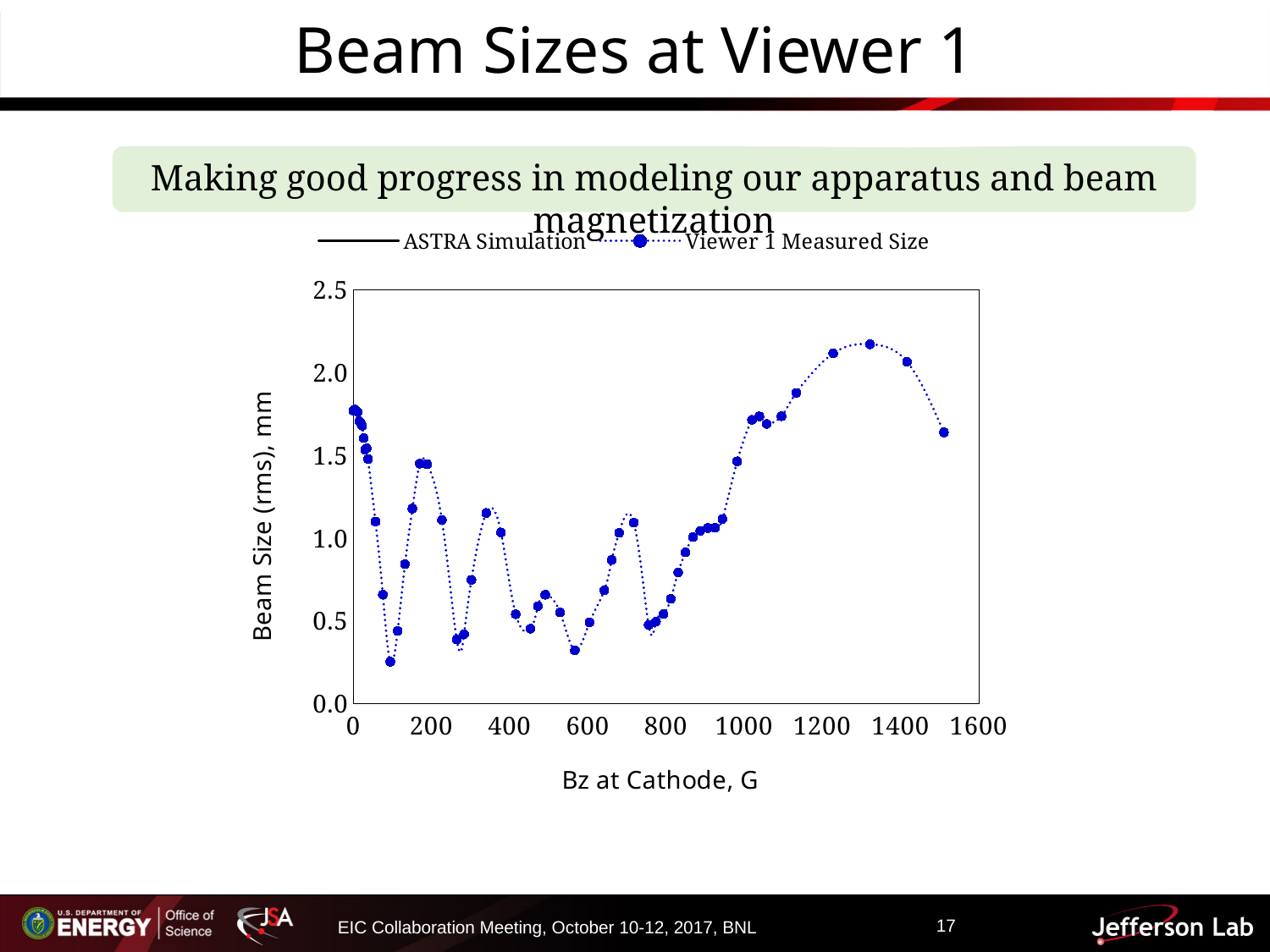
What is the maximum value shown on the y axis? 2.5 Is the Viewer 1 Measured Size at Bz = 0 G greater or less than 1.5 mm? greater Does the Viewer 1 Measured Size rise or fall as Bz increases from 1000 G to 1300 G? rise What kind of chart is shown on the slide? line chart Does the Viewer 1 Measured Size rise or fall as Bz increases from 1300 G to 1500 G? fall What is the label of the y axis? Beam Size (rms), mm Which is larger, the Viewer 1 Measured Size at about 1300 G or at about 100 G? at about 1300 G Is the highest Viewer 1 Measured Size on the chart greater or less than 2.0 mm? greater Is the lowest Viewer 1 Measured Size on the chart greater or less than 0.5 mm? less How many series does the legend list? 2 What is the label of the x axis? Bz at Cathode, G